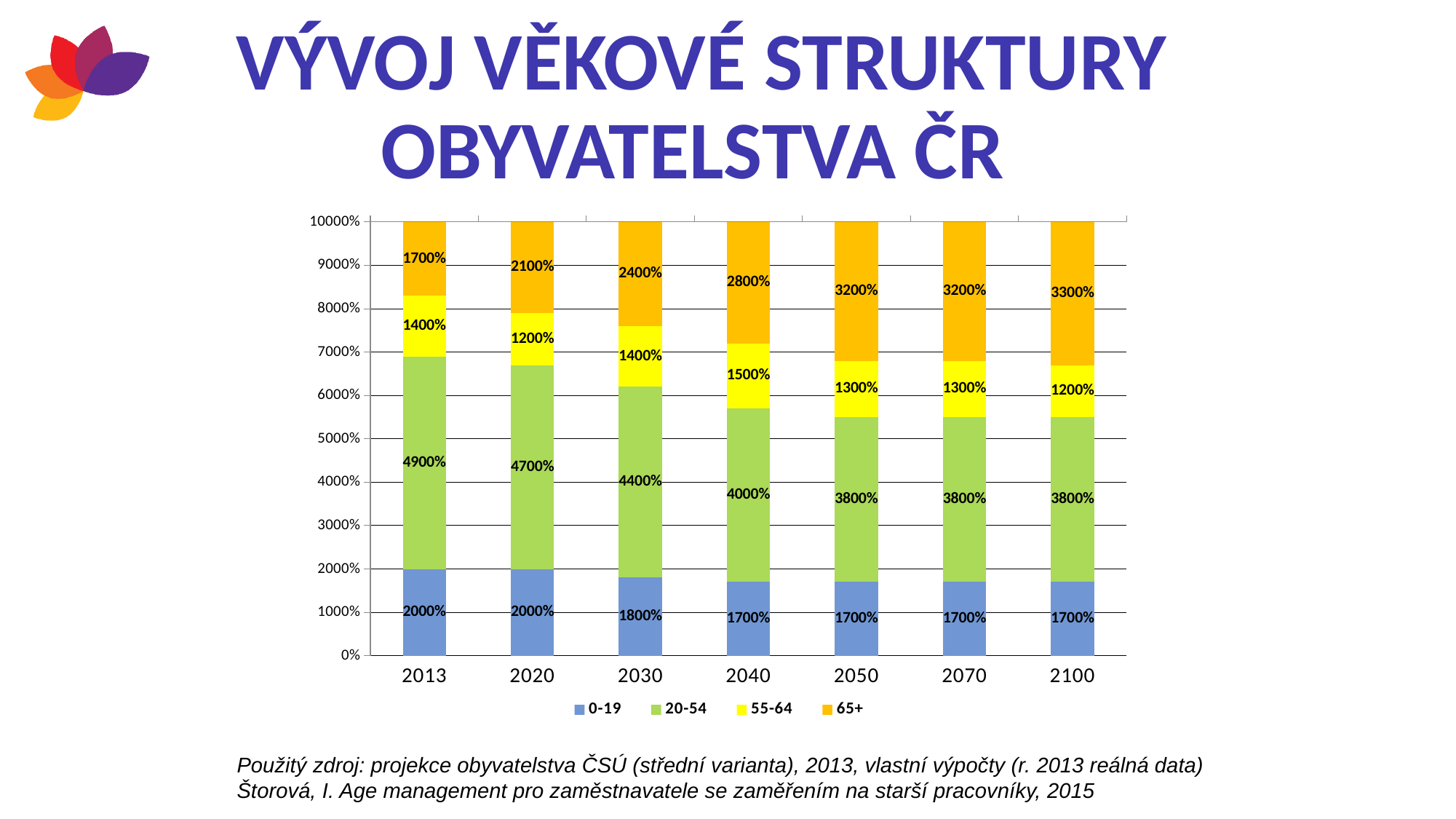
What kind of chart is shown on the slide? stacked bar chart In which year is the 65+ series highest? 2100 What is the difference between the 65+ value in 2100 and the 65+ value in 2013? 1600% What is the value for the 55-64 series in 2100? 1200% Which is larger in 2050: the 55-64 value or the 65+ value? 65+ What is the value for the 20-54 series in 2040? 4000% Does the 65+ series rise or fall from 2013 to 2100? rise How many series does the legend list? 4 What is the value for the 65+ series in 2013? 1700% What is the value for the 0-19 series in 2030? 1800% In which year is the 20-54 series highest? 2013 How many years are shown on the x axis? 7